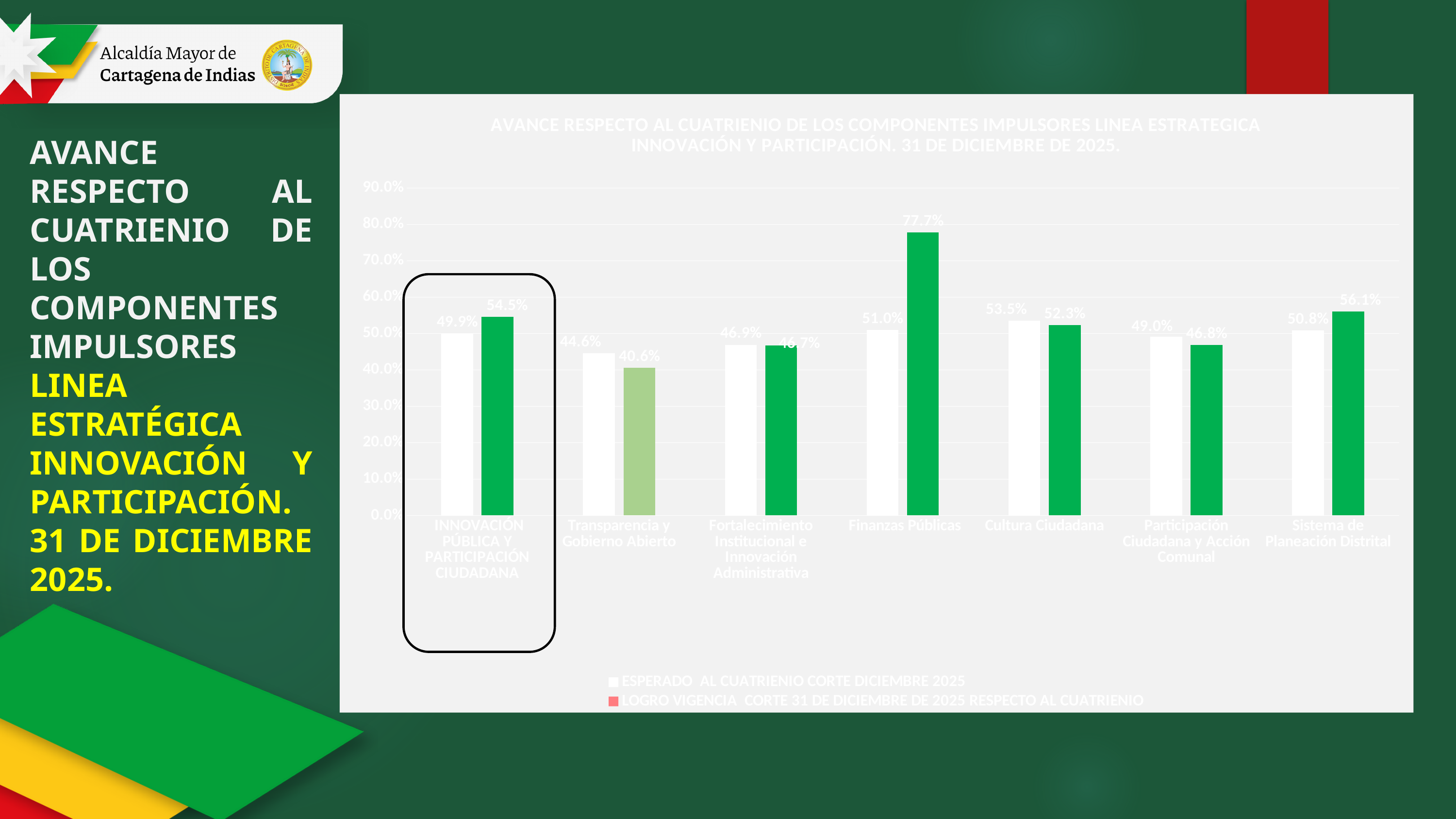
What is the LOGRO VIGENCIA value for Sistema de Planeación Distrital? 56.1% What is the ESPERADO AL CUATRIENIO value for Transparencia y Gobierno Abierto? 44.6% How many series does the chart legend list? 2 Which category has the lowest LOGRO VIGENCIA value? Transparencia y Gobierno Abierto For Cultura Ciudadana, which is larger: the ESPERADO value or the LOGRO VIGENCIA value? ESPERADO What is the difference between the LOGRO VIGENCIA and ESPERADO values for Finanzas Públicas? 26.7% How many categories are shown on the x axis of the chart? 7 What type of chart is shown on the slide? bar chart Which category is highlighted with a black rounded outline on the chart? INNOVACIÓN PÚBLICA Y PARTICIPACIÓN CIUDADANA Which category has the highest LOGRO VIGENCIA value? Finanzas Públicas Is the LOGRO VIGENCIA value for Finanzas Públicas greater or less than 70.0%? greater What is the LOGRO VIGENCIA value for Finanzas Públicas? 77.7%